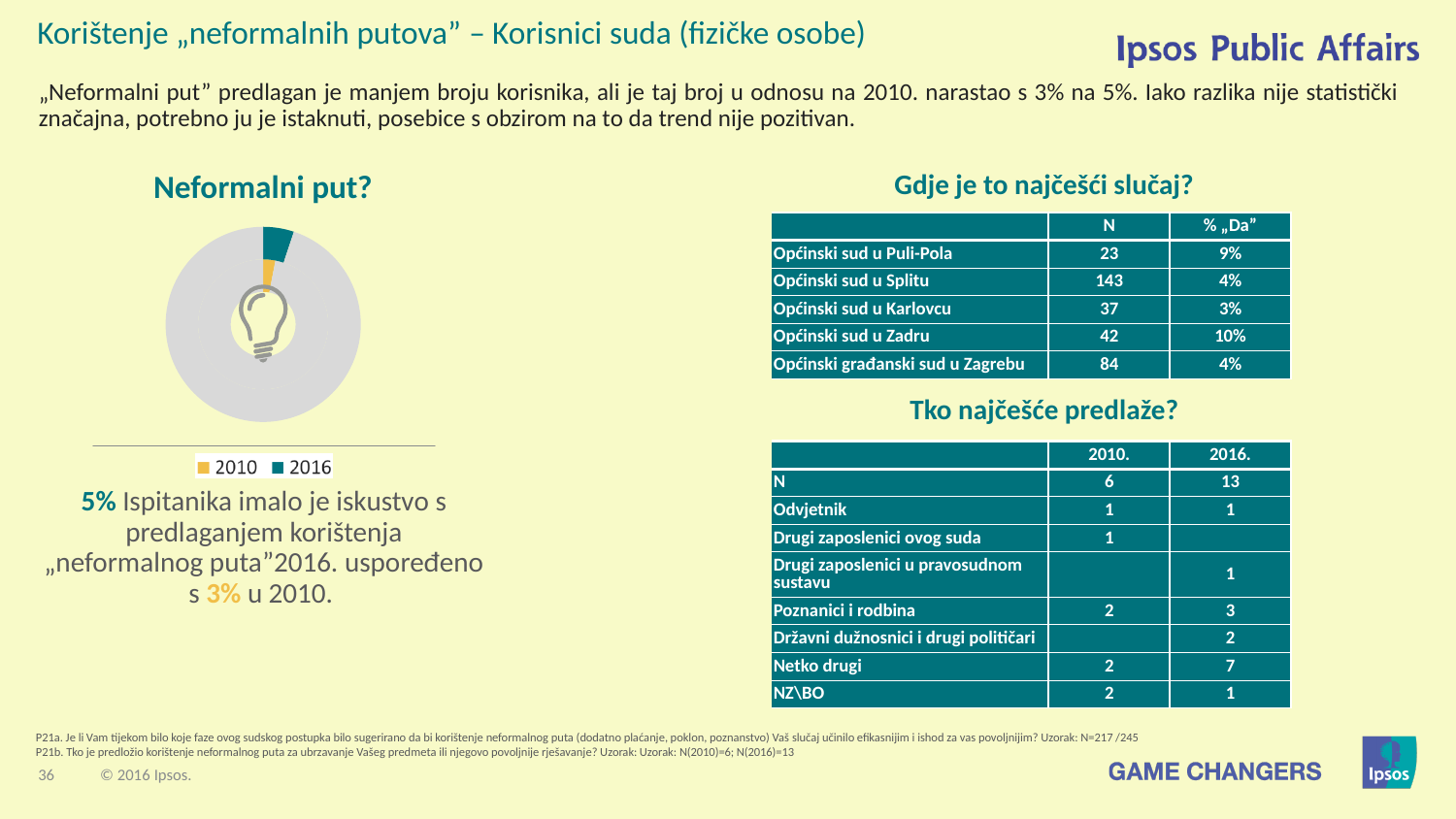
What is the title of the chart on the left side of the slide? Neformalni put? Does the share for "neformalni put" rise or fall from 2010 to 2016? Rise In the "Neformalni put?" chart, which colour represents 2016? Teal By how many percentage points did the share for "neformalni put" change from 2010 to 2016, according to the slide? 2 percentage points According to the slide, what share of respondents had experience with the "neformalni put" being proposed in 2010? 3% In the "Neformalni put?" chart, which year has the larger slice, 2010 or 2016? 2016 How many series does the legend of the "Neformalni put?" chart list? 2 What are the two legend entries of the "Neformalni put?" chart? 2010 and 2016 What kind of chart is shown under the heading "Neformalni put?"? Doughnut chart According to the slide, what share of respondents had experience with the "neformalni put" being proposed in 2016? 5%